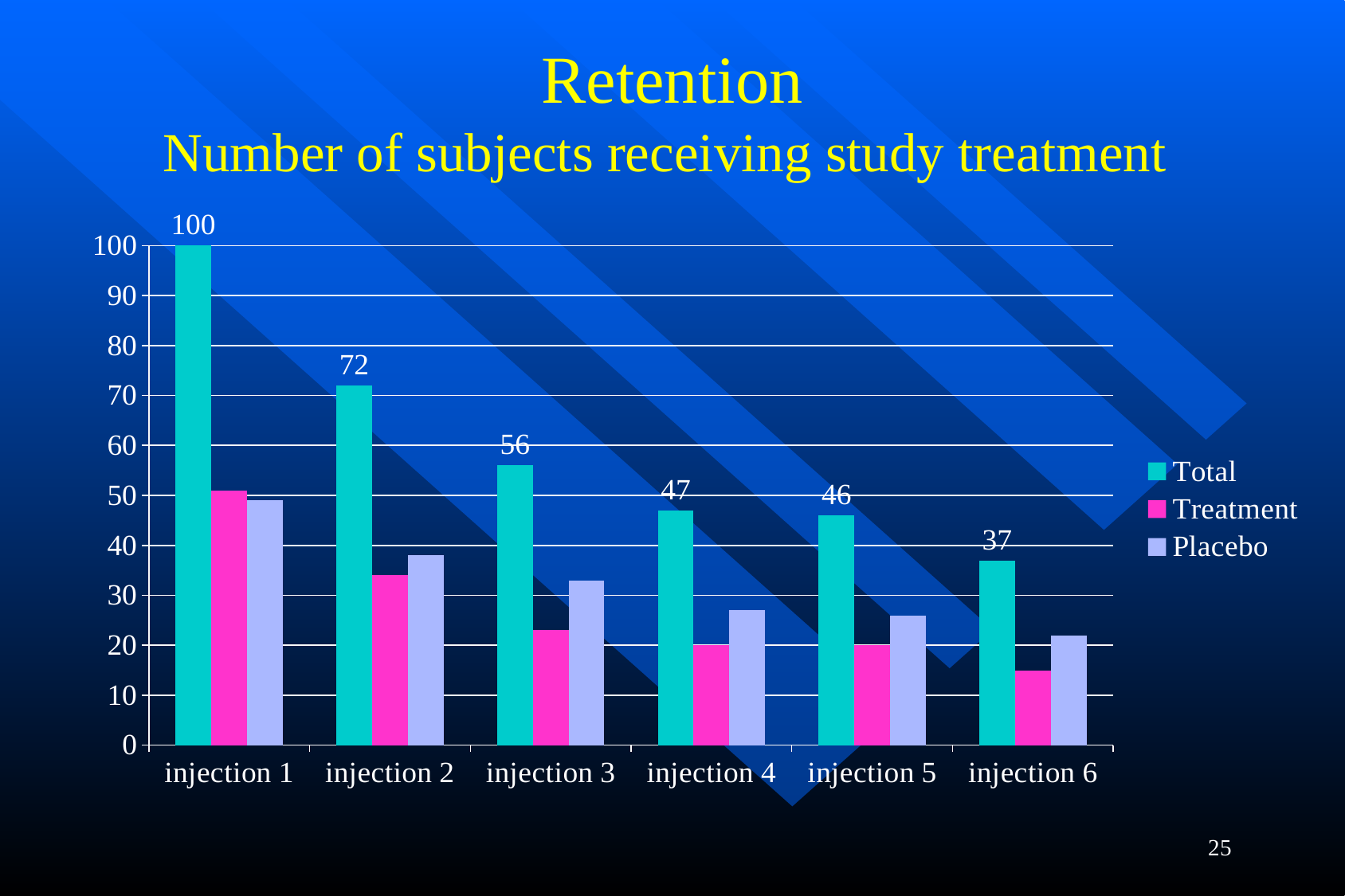
Is the Treatment value for injection 6 greater or less than 20? less What is the Total value for injection 6? 37 Which injection has the highest Total value? injection 1 What is the difference between the Total values for injection 1 and injection 2? 28 What is the difference between the Total values for injection 3 and injection 6? 19 Which injection has the lowest Total value? injection 6 At injection 3, which is larger, the Treatment bar or the Placebo bar? Placebo How many series does the legend list? 3 What is the Total value for injection 1? 100 Is the Placebo value for injection 2 greater or less than 30? greater How many injections are shown on the x axis? 6 What is the Total value for injection 3? 56